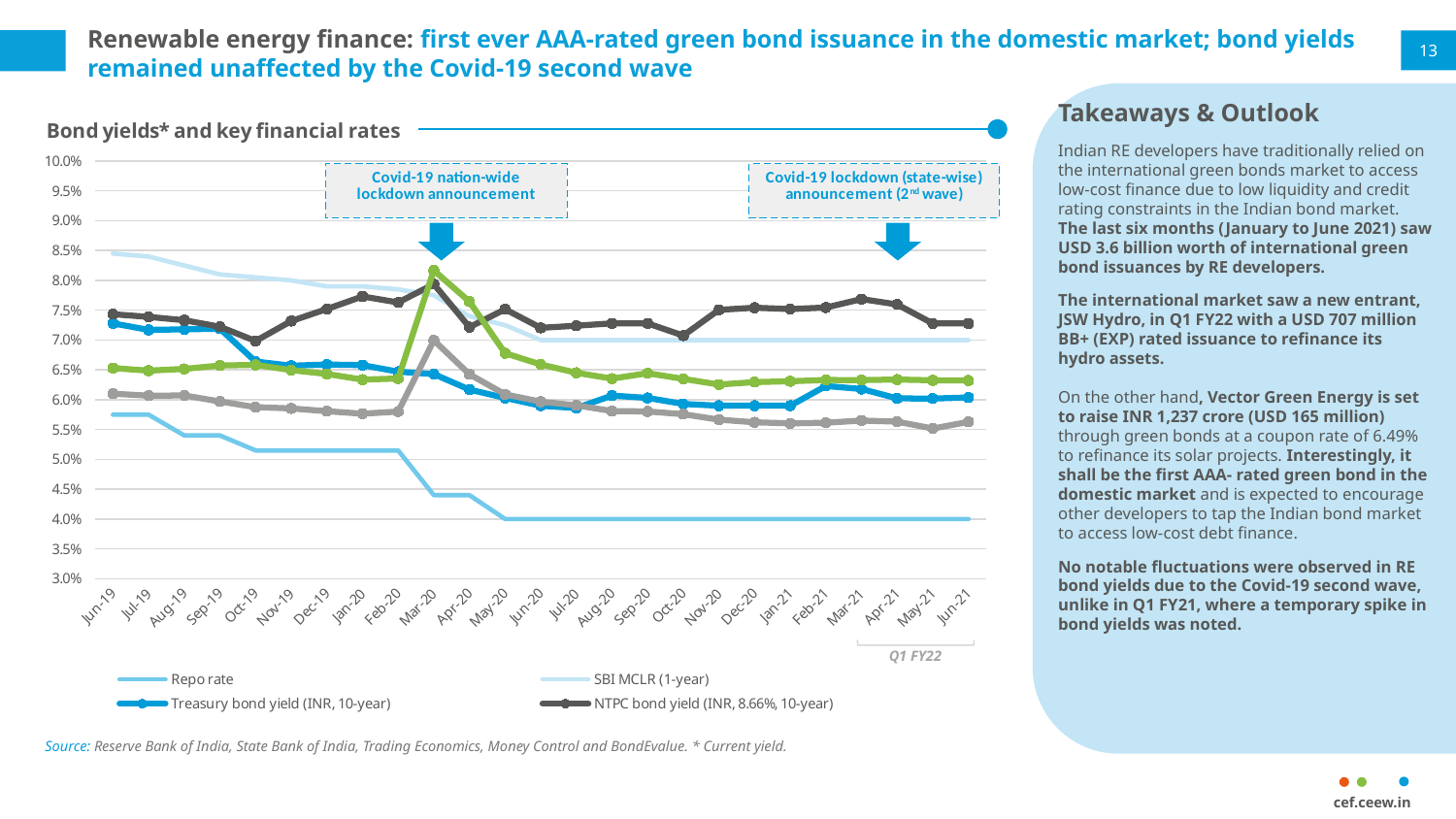
In Jun-21, which is larger: the NTPC bond yield (INR, 8.66%, 10-year) or the Treasury bond yield (INR, 10-year)? NTPC bond yield (INR, 8.66%, 10-year) Is the Treasury bond yield (INR, 10-year) in Mar-20 greater or less than 6.0%? greater What event does the first annotation box on the chart mark? Covid-19 nation-wide lockdown announcement What kind of chart is shown on the slide? line chart Which series has the lowest value in Jun-21? Repo rate Which series has the highest value in Jun-19? SBI MCLR (1-year) How many months are shown along the x axis of the chart? 25 Is the SBI MCLR (1-year) value in Jun-19 greater or less than 8.0%? greater What is the repo rate in Jun-21? 4.0% What is the title of the chart? Bond yields* and key financial rates Does the repo rate rise or fall from Jun-19 to Jun-21? fall How many series does the chart legend list? 4